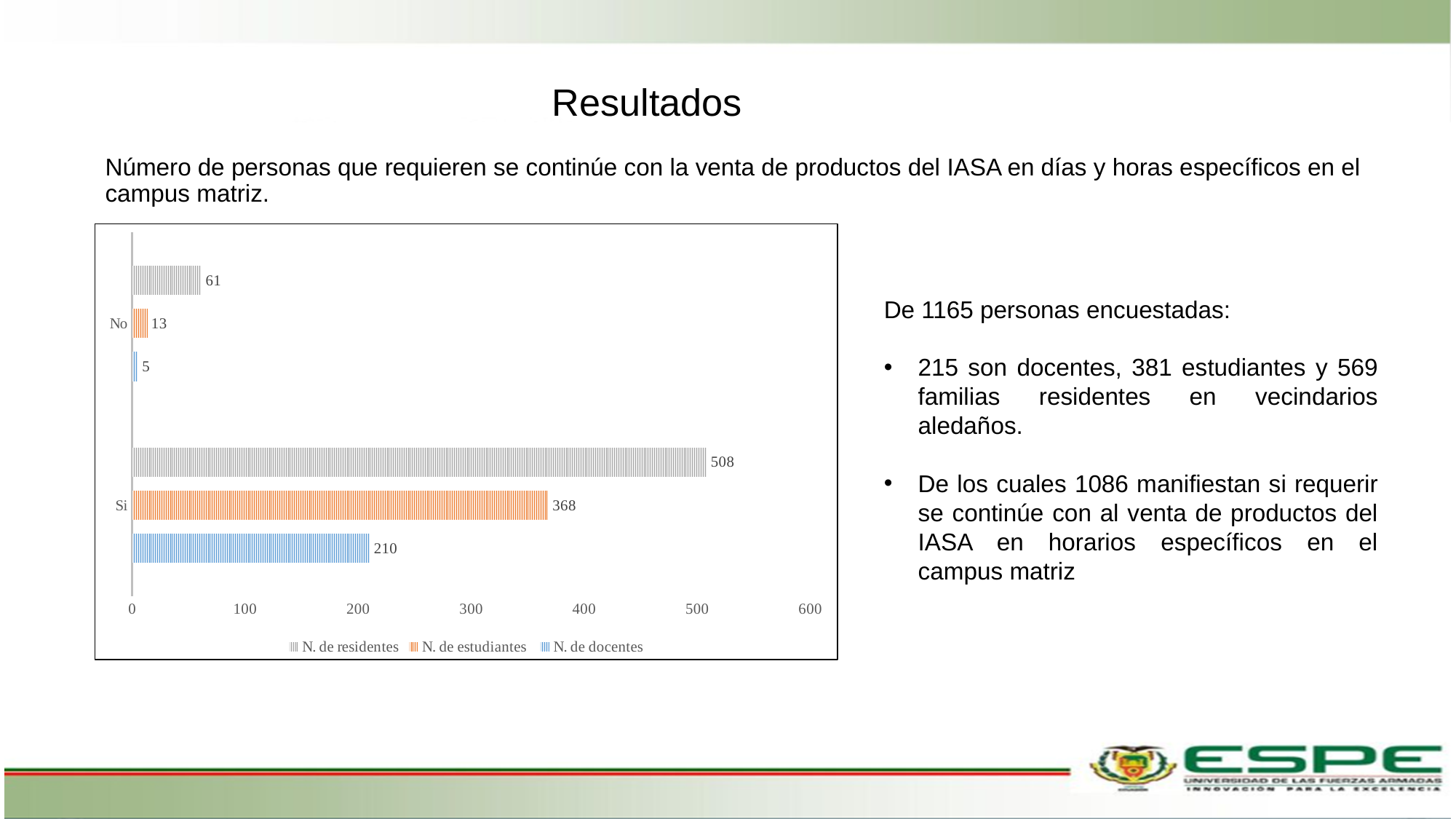
Which series has the highest value in the Si category? N. de residentes What is the value for N. de residentes in the Si category? 508 What kind of chart is shown on the slide? Bar chart What is the value for N. de docentes in the Si category? 210 What is the value for N. de estudiantes in the No category? 13 What is the value for N. de docentes in the No category? 5 Which is larger: N. de residentes for No or N. de docentes for Si? N. de docentes for Si Is the value for N. de estudiantes in the Si category greater or less than 300? greater How many categories are shown on the vertical axis of the chart? 2 What is the difference between N. de residentes and N. de estudiantes in the Si category? 140 How many series does the legend list? 3 Which series has the lowest value in the No category? N. de docentes